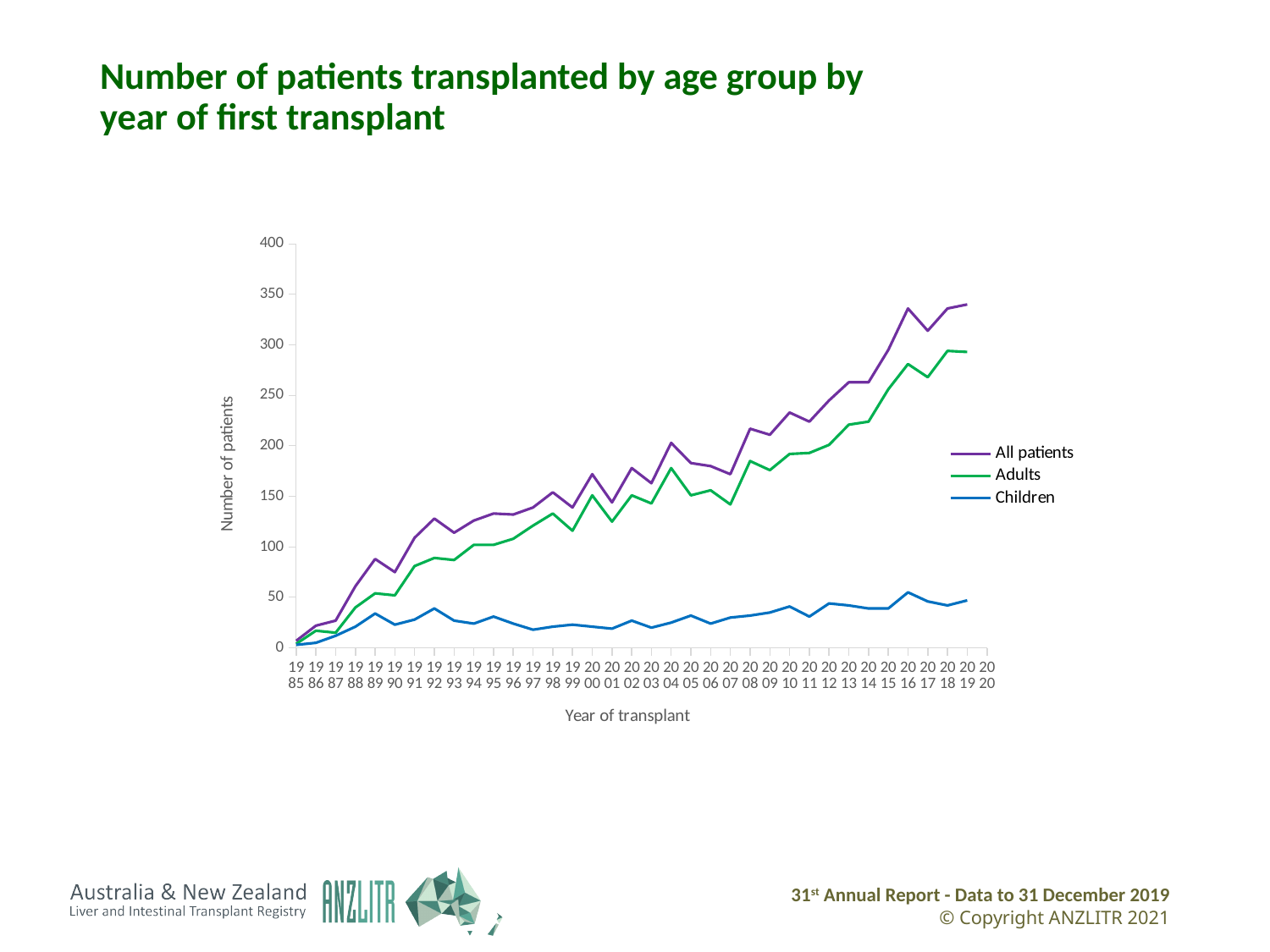
Is the value for Children in 2019 greater or less than 100? less What is the label on the vertical axis? Number of patients Which series has the highest value in 2019? All patients How many series does the legend list? 3 Is the value for All patients in 2019 greater or less than 300? greater Does the All patients line generally rise or fall from 1985 to 2019? rise Which series has the lowest value in 2019? Children Which is larger in 2010, the value for Adults or the value for Children? Adults Is the value for Adults in 2019 greater or less than 250? greater What kind of chart is shown on the slide? line chart